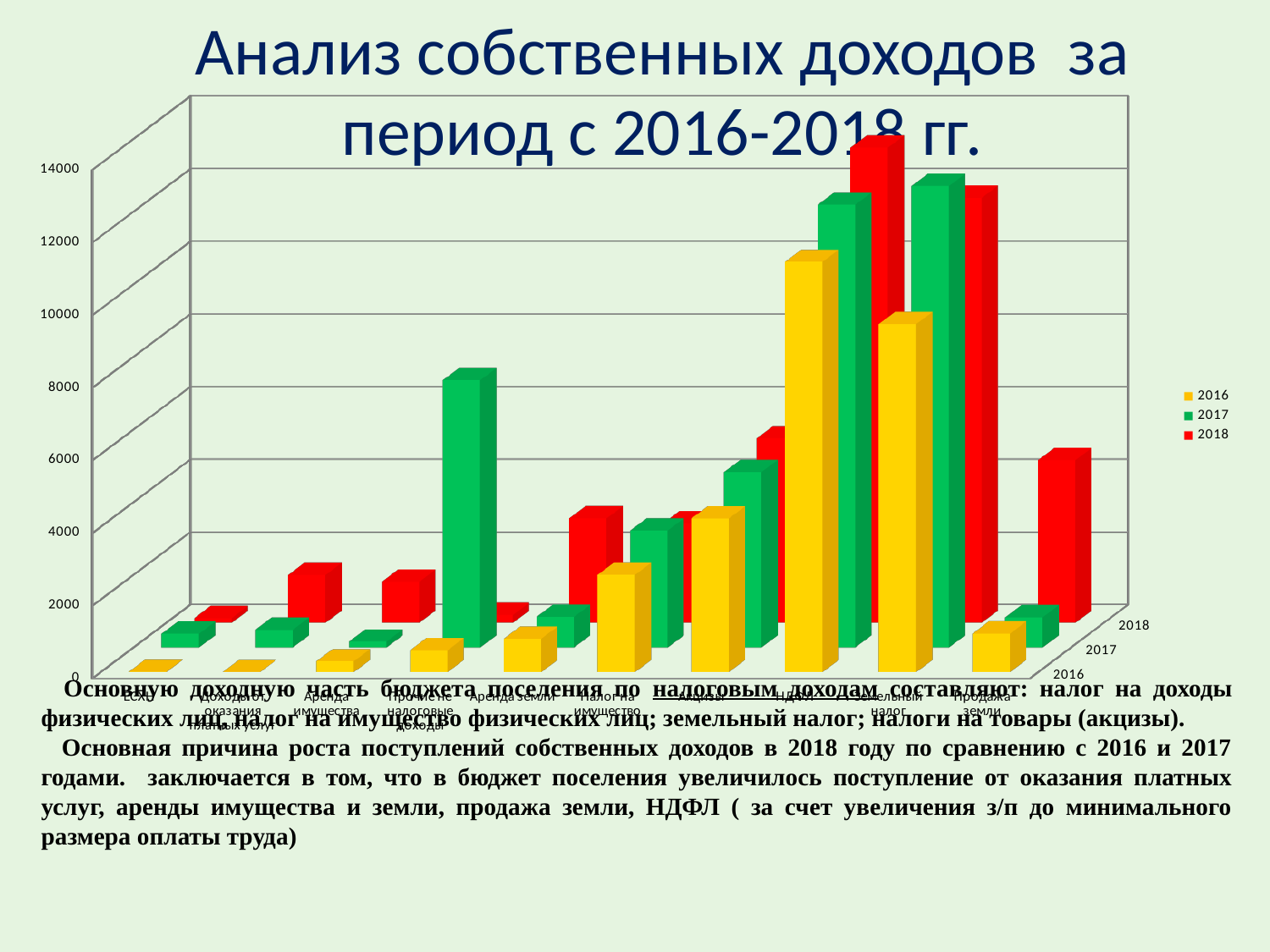
How many series does the legend list? 3 For НДФЛ, which is larger: the 2016 value or the 2018 value? 2018 Is the 2017 value for Аренда земли greater or less than 6000? less Which category has the highest value in the 2016 series? НДФЛ Is the 2016 value for НДФЛ greater or less than 10000? greater How many categories are plotted along the x axis of the chart? 10 What colour represents the 2018 series in the chart? red Which category has the tallest bar in the chart overall? НДФЛ Is the 2016 value for ЕСХН greater or less than 2000? less Which years are listed in the chart legend? 2016, 2017, 2018 What kind of chart is shown on the slide? bar chart